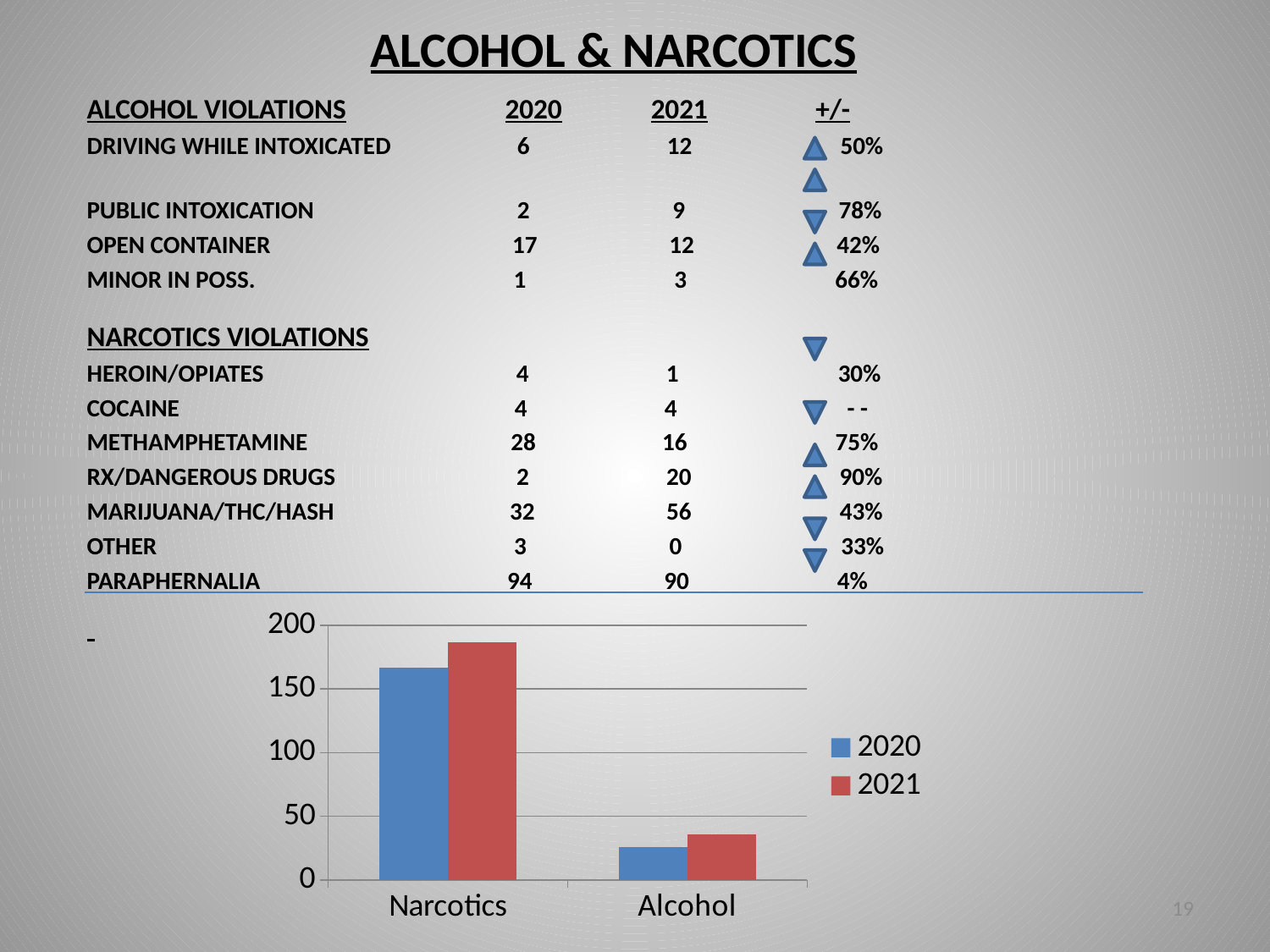
In the chart, is the 2020 value for Narcotics greater or less than 150? greater How many categories are shown on the x axis of the chart? 2 In the chart, is the 2021 value for Narcotics greater or less than 200? less Which category and series has the shortest bar in the chart? Alcohol, 2020 For Narcotics, which year has the larger bar in the chart, 2020 or 2021? 2021 Which category and series has the tallest bar in the chart? Narcotics, 2021 What colour are the 2021 bars in the chart? red In the chart, is the 2020 value for Alcohol greater or less than 50? less How many series does the chart legend list? 2 For Alcohol, which year has the larger bar in the chart, 2020 or 2021? 2021 What kind of chart is shown at the bottom of the slide? bar chart